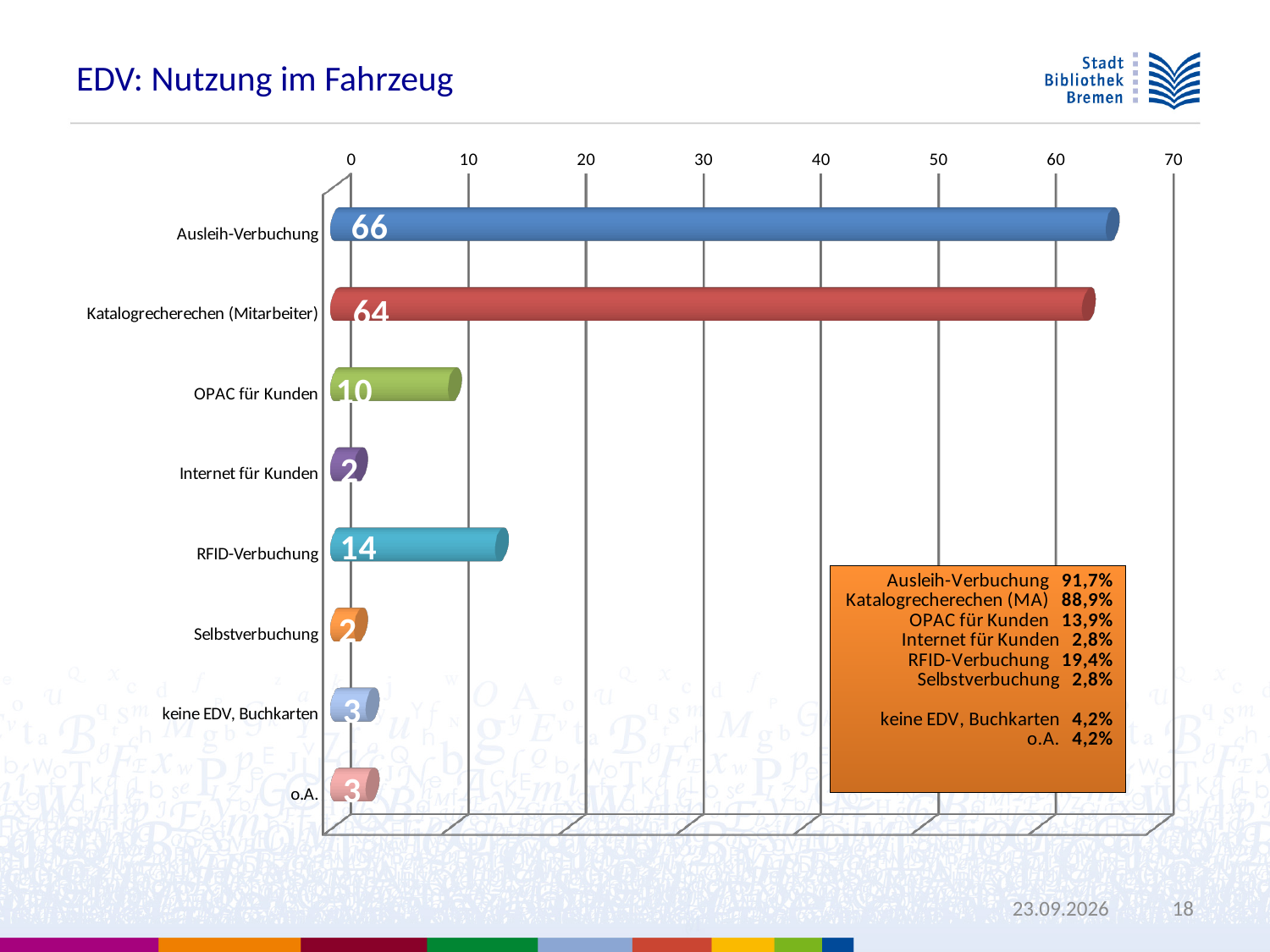
What is the value for OPAC für Kunden? 10 Is the value for Katalogrecherechen (Mitarbeiter) greater or less than 60? greater Which category has the highest value? Ausleih-Verbuchung What is the value for RFID-Verbuchung? 14 What is the value for Selbstverbuchung? 2 What is the title of the slide containing the chart? EDV: Nutzung im Fahrzeug What is the difference between Ausleih-Verbuchung and Katalogrecherechen (Mitarbeiter)? 2 How many categories are shown in the chart? 8 What is the value for Ausleih-Verbuchung? 66 What kind of chart is shown on the slide? bar chart Which is larger, RFID-Verbuchung or OPAC für Kunden? RFID-Verbuchung According to the text box on the chart, what percentage is given for RFID-Verbuchung? 19,4%